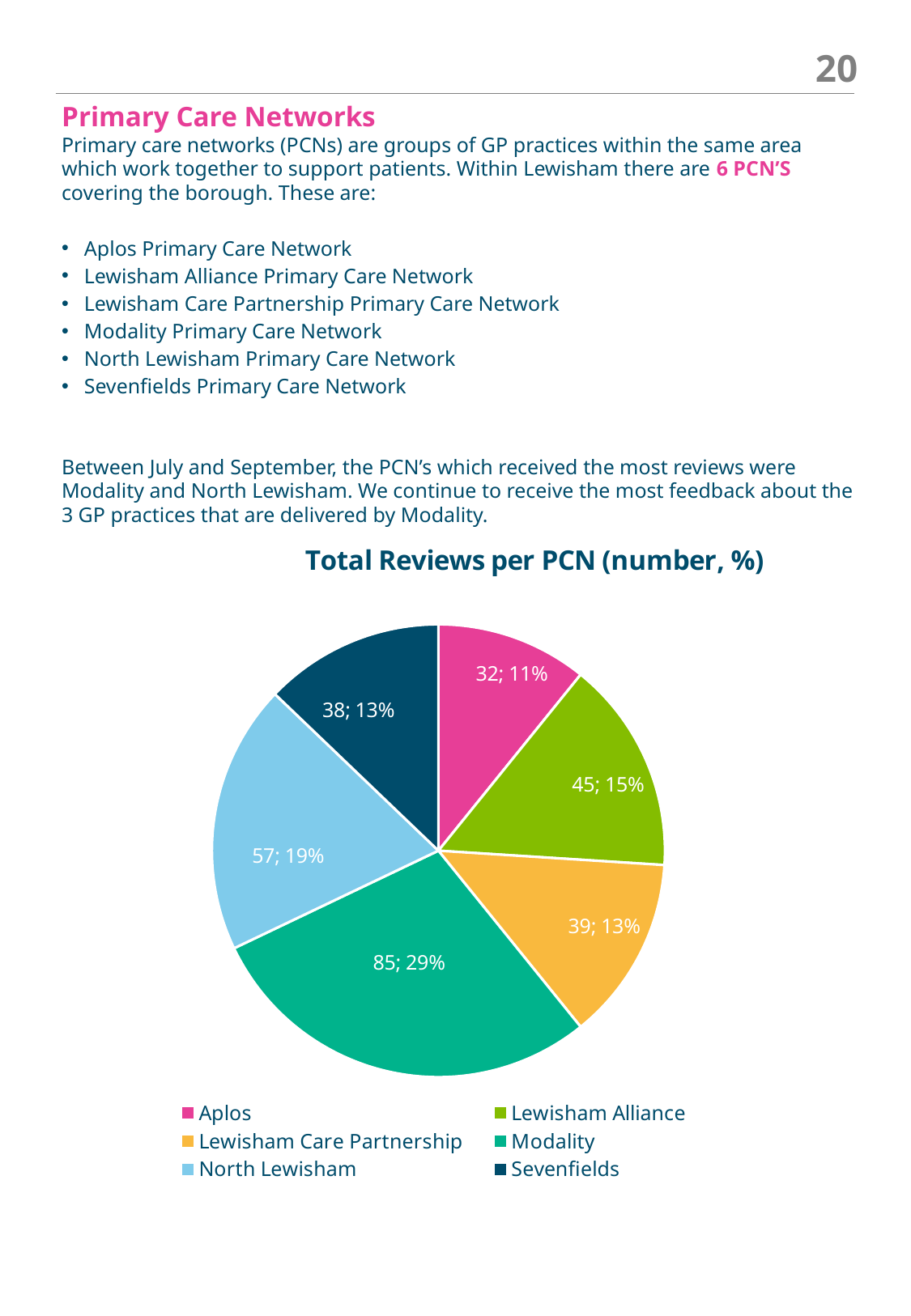
What type of chart is used to show Total Reviews per PCN? Pie chart How many PCNs are shown as slices in the pie chart? 6 What is the number of reviews for Aplos in the pie chart? 32 Which PCN received the fewest reviews according to the pie chart? Aplos What percentage of total reviews does Lewisham Alliance account for? 15% What is the difference in reviews between Lewisham Alliance and Sevenfields? 7 What is the title of the chart on the slide? Total Reviews per PCN (number, %) What percentage share does North Lewisham have in the Total Reviews per PCN pie chart? 19% Which PCN received the most reviews according to the pie chart? Modality How many more reviews did Modality receive than North Lewisham? 28 Which received more reviews, Lewisham Care Partnership or Sevenfields? Lewisham Care Partnership What is the number of reviews for Modality in the Total Reviews per PCN pie chart? 85